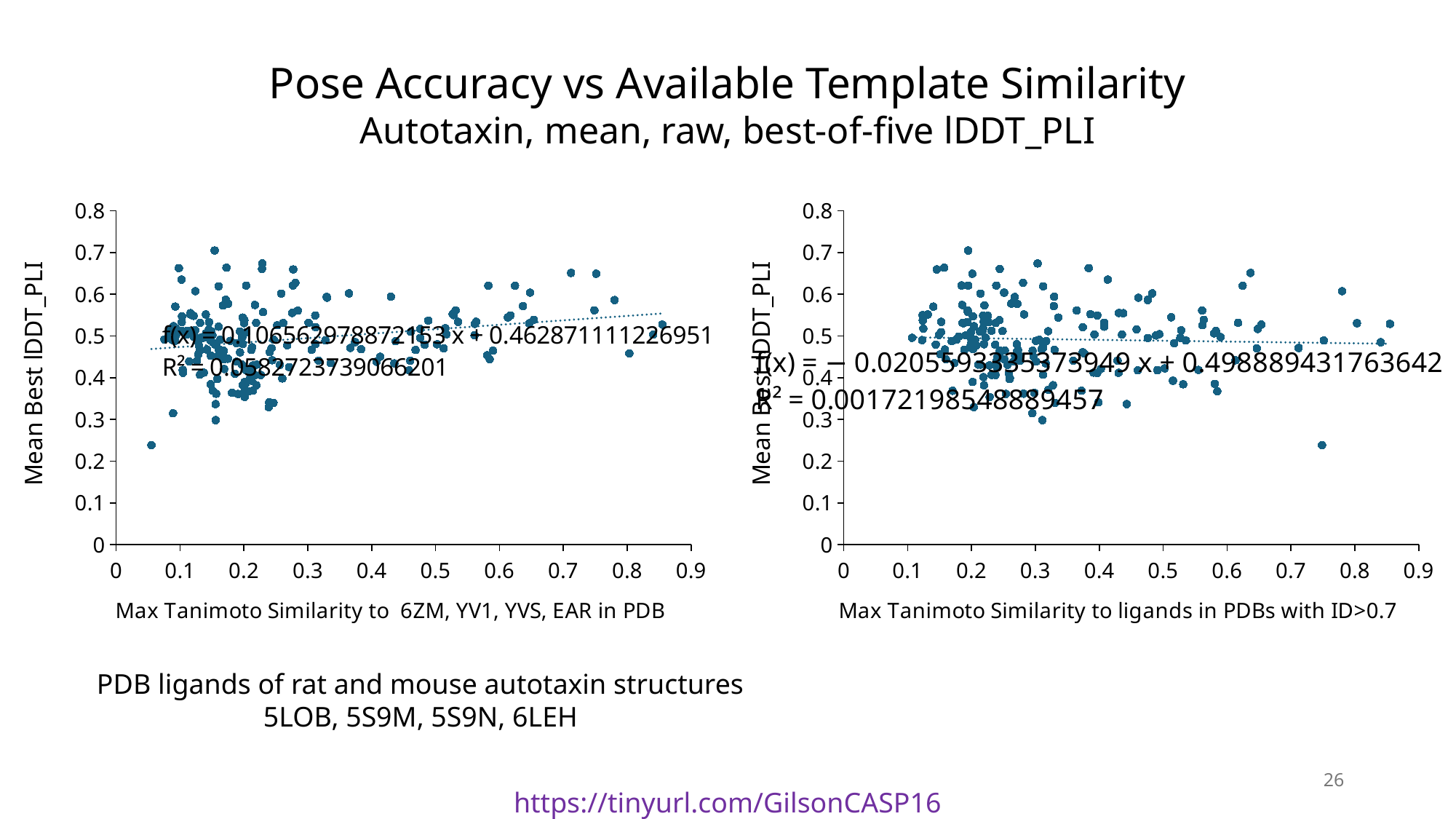
In the left chart, is the Mean Best lDDT_PLI of the lowest point greater or less than 0.3? less In the left chart, what is the R² value printed for the trendline? 0.0582723739066201 What is the maximum value shown on the x axis of the right chart? 0.9 In the left chart, does the fitted trendline rise or fall as Max Tanimoto Similarity increases? Rises In the left chart, is the Mean Best lDDT_PLI of the highest point greater or less than 0.6? greater In the right chart, is the Mean Best lDDT_PLI of the highest point greater or less than 0.6? greater What is the maximum value shown on the y axis of the left chart? 0.8 In the right chart, what is the R² value printed for the trendline? 0.00172198548889457 What kind of chart is the left chart on the slide? Scatter chart In the right chart, does the fitted trendline rise or fall as Max Tanimoto Similarity increases? Falls Which chart has the trendline with the larger R² value, the left or the right? Left